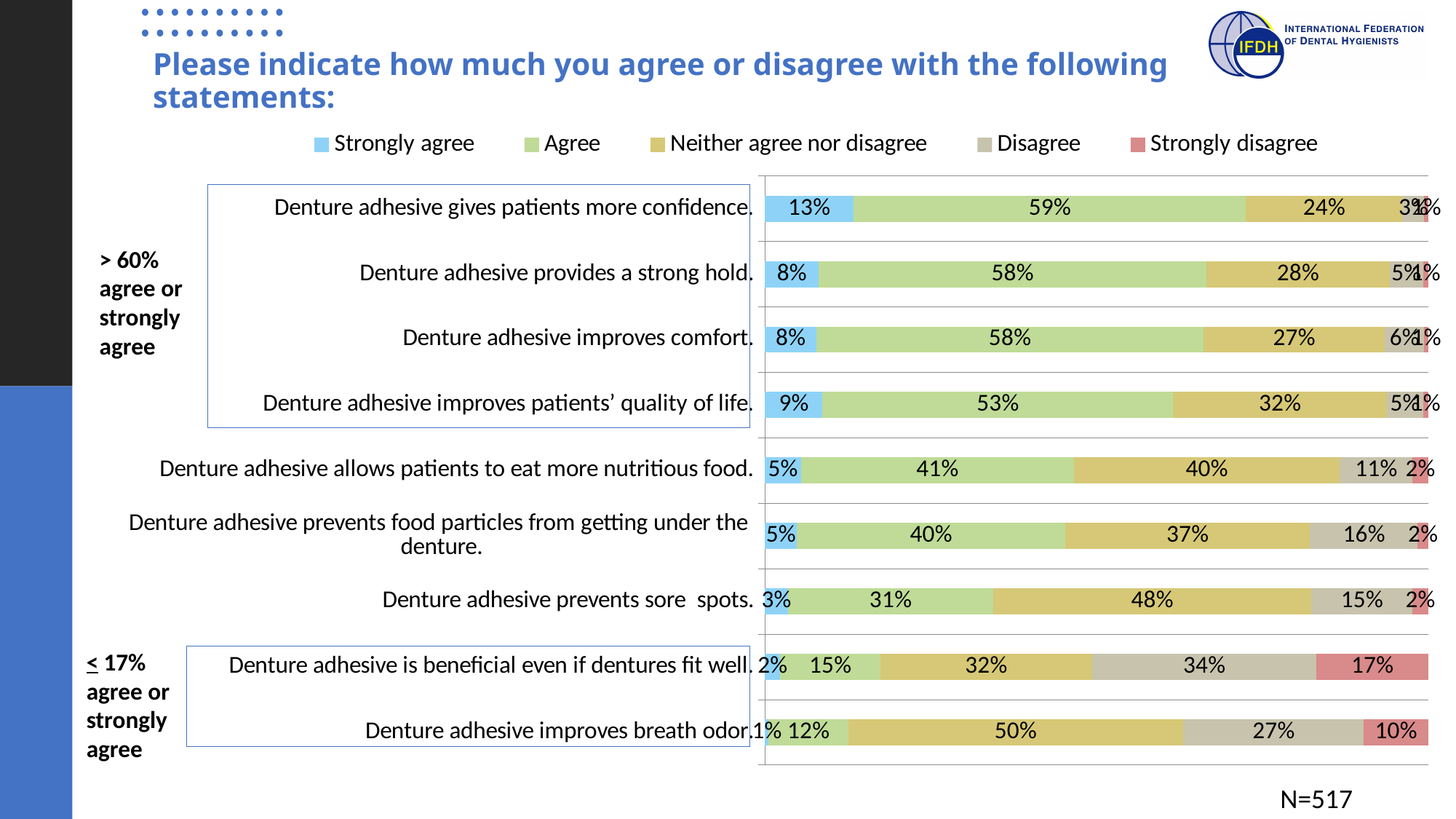
What percentage of respondents 'Agree' that denture adhesive gives patients more confidence? 59% What sample size (N) is shown on the slide? N=517 What percentage 'Disagree' that denture adhesive prevents food particles from getting under the denture? 16% What is the difference between the 'Neither agree nor disagree' percentages for 'prevents sore spots' and 'improves patients' quality of life'? 16% What kind of chart is shown on the slide? Stacked bar chart Which statement has the highest 'Strongly disagree' percentage? Denture adhesive is beneficial even if dentures fit well. What percentage 'Strongly disagree' that denture adhesive is beneficial even if dentures fit well? 17% How many series does the legend list? 5 How many statements (categories) are plotted in the chart? 9 Which has a larger 'Agree' percentage: 'allows patients to eat more nutritious food' or 'prevents sore spots'? Denture adhesive allows patients to eat more nutritious food. Which statement has the highest 'Strongly agree' percentage? Denture adhesive gives patients more confidence. What percentage chose 'Neither agree nor disagree' for the statement that denture adhesive improves breath odor? 50%